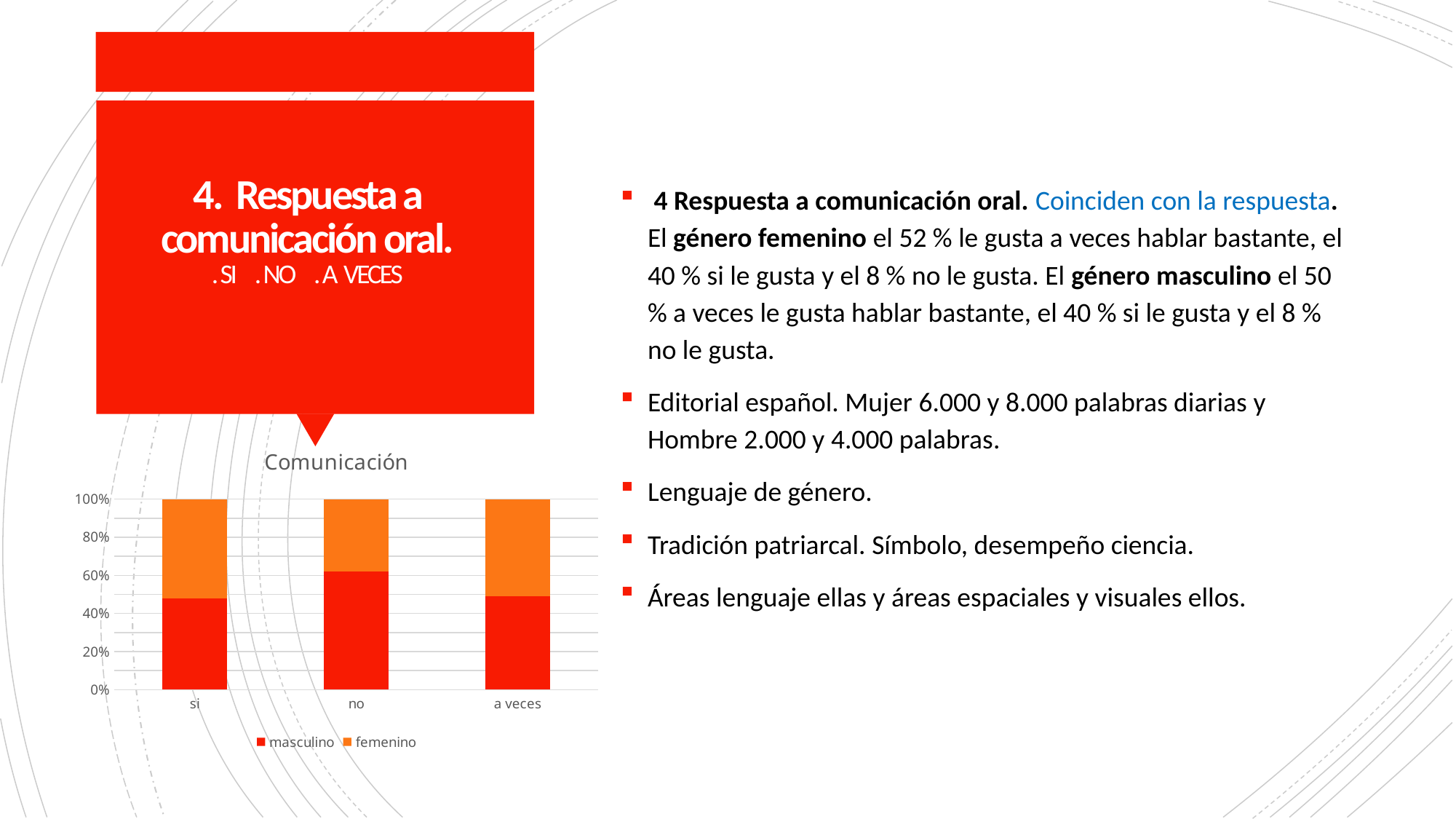
What is the title of the chart? Comunicación Which series are listed in the chart legend? masculino, femenino Is the masculino share for 'no' larger or smaller than the masculino share for 'si'? larger Is the masculino value for 'a veces' greater or less than 20%? greater What type of chart is shown on the slide? stacked bar chart Is the masculino value for 'no' greater or less than 80%? less What is the total height of the stacked bar for 'si'? 100% Is the masculino value for 'no' greater or less than 40%? greater How many categories are shown on the x axis of the chart? 3 Which category has the largest masculino share in the chart? no How many series does the chart legend list? 2